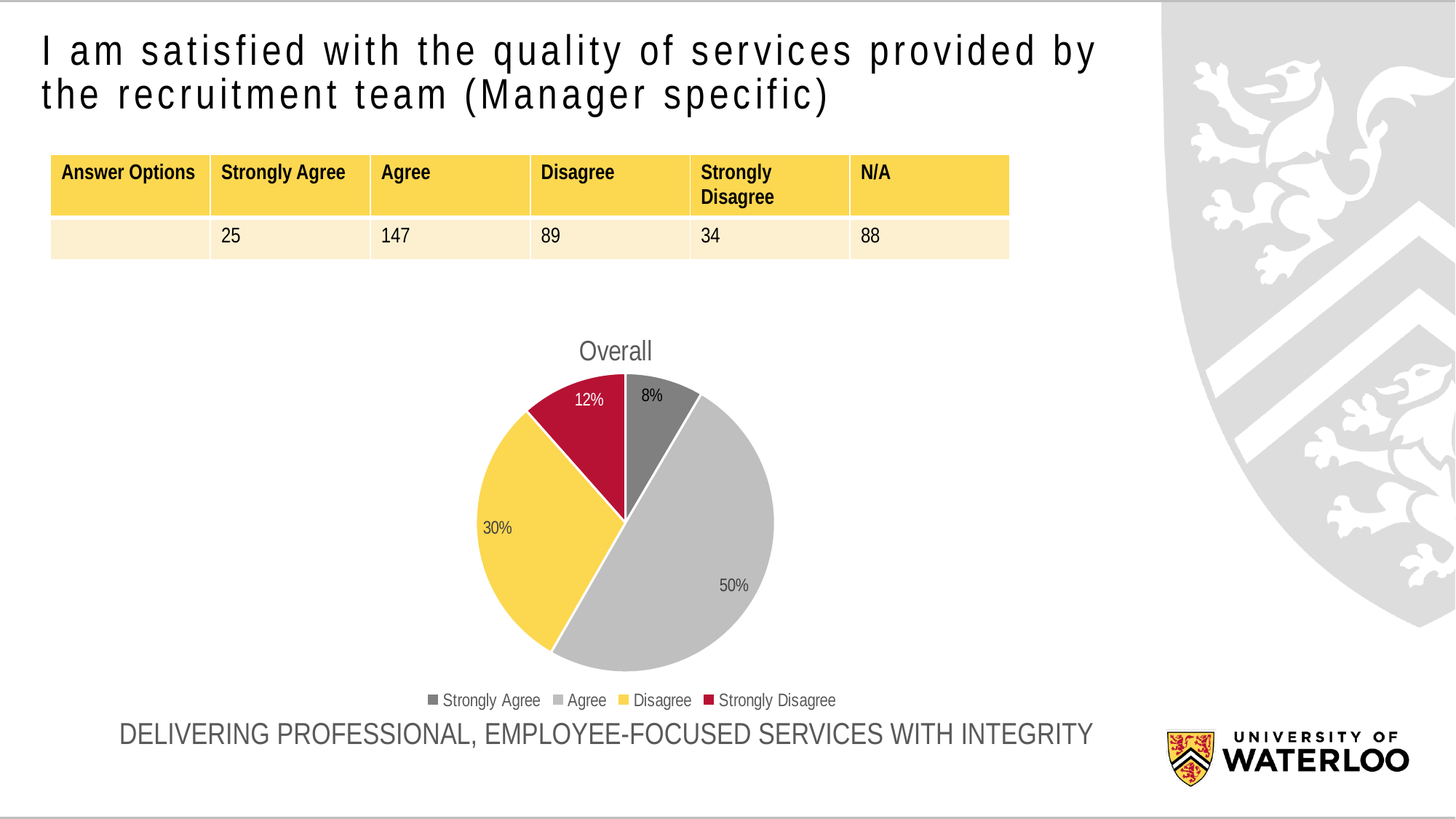
What type of chart is shown on the slide? pie chart Which slice is larger, Disagree or Strongly Disagree? Disagree What percentage of the pie does the Agree slice represent? 50% What is the title of the chart? Overall What colour is the Strongly Disagree slice? red Which category has the largest slice of the pie? Agree Which category has the smallest slice of the pie? Strongly Agree What is the difference in percentage points between the Agree and Disagree slices? 20 What percentage of the pie does the Disagree slice represent? 30% What percentage of the pie does the Strongly Agree slice represent? 8% How many categories does the legend list? 4